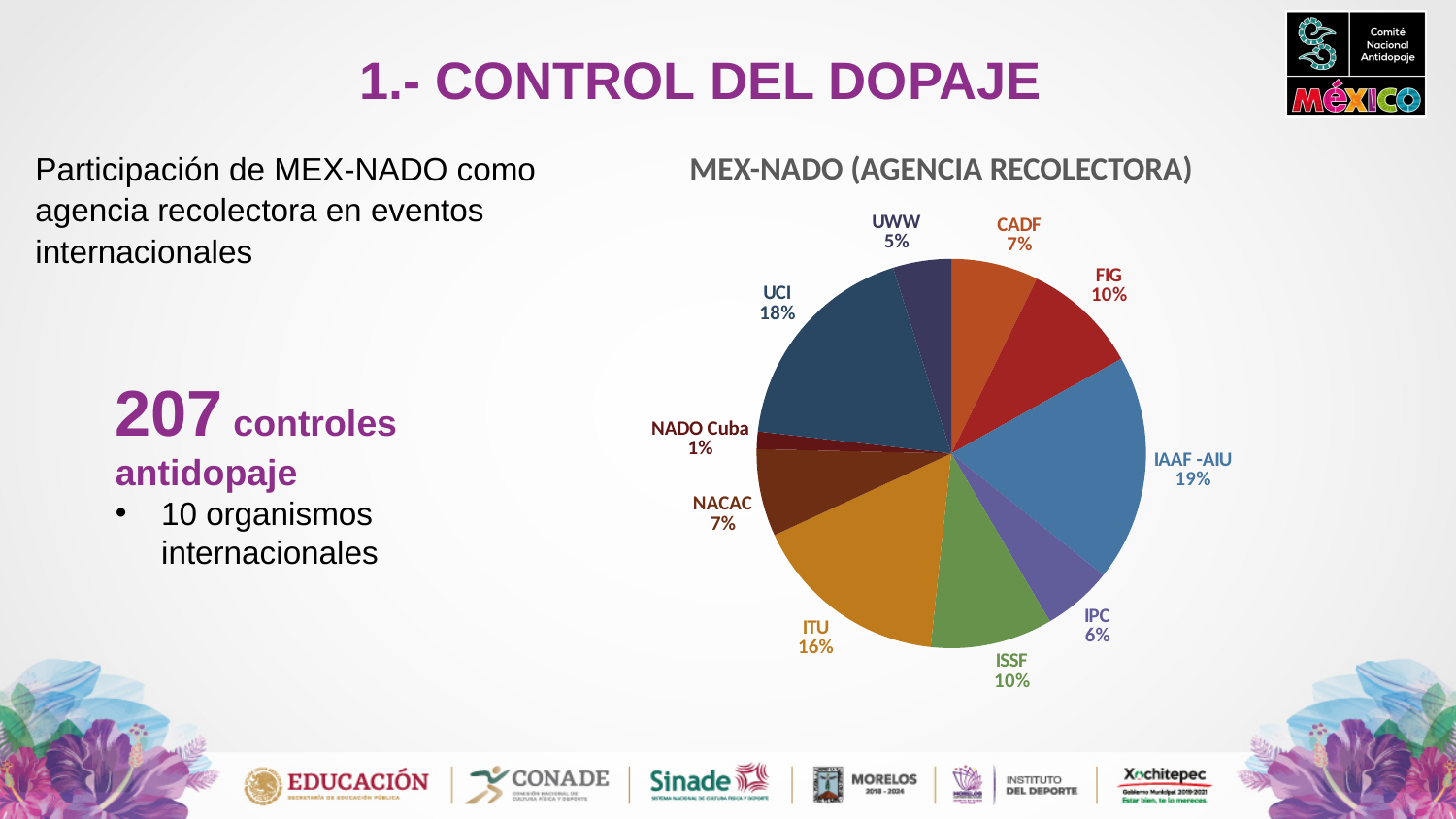
Which category has the largest slice of the pie? IAAF -AIU What is the value shown for NACAC? 7% What is the value shown for ITU? 16% What is the title of the chart? MEX-NADO (AGENCIA RECOLECTORA) How many slices does the pie chart have? 10 What is the difference between the shares of UCI and ITU? 2% Which is larger, the share for FIG or the share for IPC? FIG What type of chart is shown on the slide? pie chart What is the value shown for UCI? 18% What share of the pie does IAAF -AIU represent? 19% Which category has the smallest slice of the pie? NADO Cuba What is the combined share of UWW and CADF? 12%